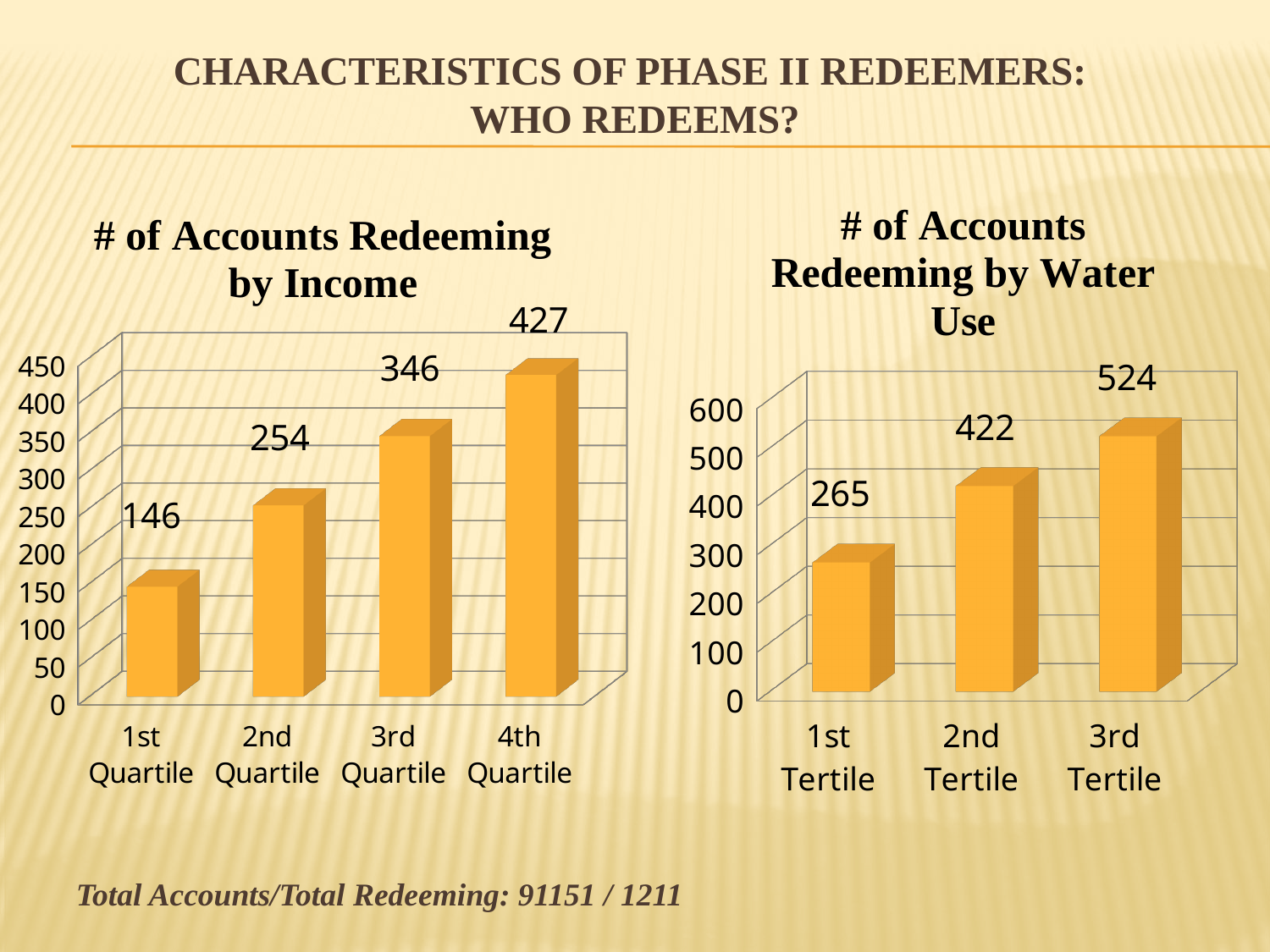
In the '# of Accounts Redeeming by Income' chart, what is the difference between the 4th Quartile and the 1st Quartile? 281 In the '# of Accounts Redeeming by Water Use' chart, what is the value for the 3rd Tertile? 524 Which is larger: the 3rd Quartile value in the income chart or the 2nd Tertile value in the water use chart? 2nd Tertile in the water use chart In the '# of Accounts Redeeming by Income' chart, which quartile has the lowest value? 1st Quartile In the '# of Accounts Redeeming by Income' chart, what is the value for the 2nd Quartile? 254 What kind of chart is the '# of Accounts Redeeming by Water Use' chart? bar chart In the '# of Accounts Redeeming by Income' chart, do the values rise or fall from the 1st Quartile to the 4th Quartile? rise In the '# of Accounts Redeeming by Water Use' chart, what is the difference between the 3rd Tertile and the 2nd Tertile? 102 In the '# of Accounts Redeeming by Income' chart, which quartile has the highest value? 4th Quartile In the '# of Accounts Redeeming by Water Use' chart, which tertile has the highest value? 3rd Tertile In the '# of Accounts Redeeming by Income' chart, how many quartile categories are shown? 4 In the '# of Accounts Redeeming by Water Use' chart, what is the value for the 1st Tertile? 265